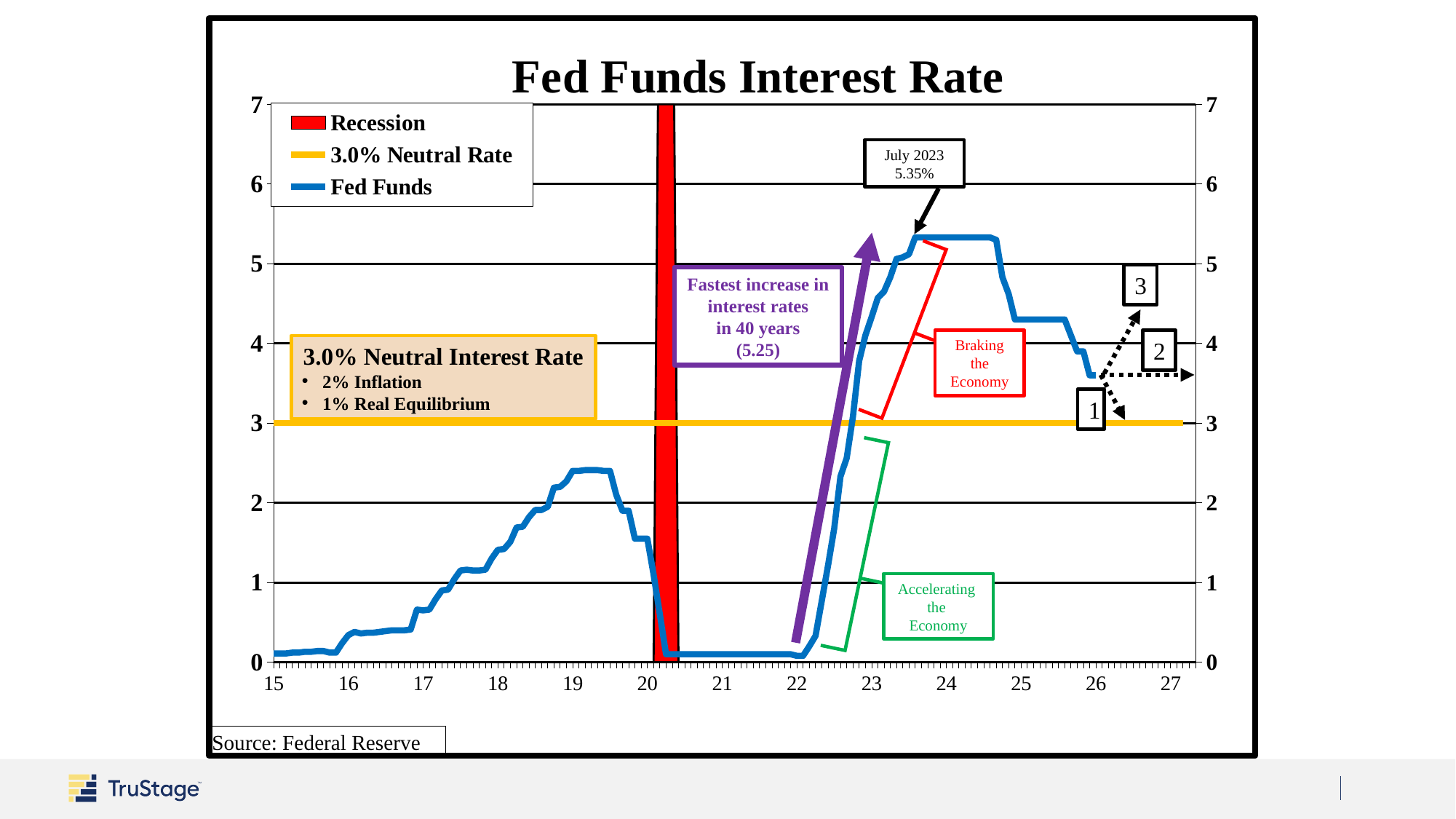
According to the annotation, how large was the fastest increase in interest rates in 40 years? 5.25 Which is higher, the Fed Funds rate in early 2024 or the Fed Funds rate in 2019? Early 2024 Is the Fed Funds rate during 2021 greater or less than 1? less What is the value of the neutral rate line shown on the chart? 3.0% Does the Fed Funds rate rise or fall between 2022 and 2023? rise Is the Fed Funds rate at the start of 2024 greater or less than 5? greater How many entries does the chart's legend list? 3 What Fed Funds rate is labeled for July 2023? 5.35% Is the Fed Funds rate in 2019 greater or less than 3? less What does the red vertical bar on the chart represent? Recession What kind of chart is shown on the slide? Line chart What is the title of the chart? Fed Funds Interest Rate